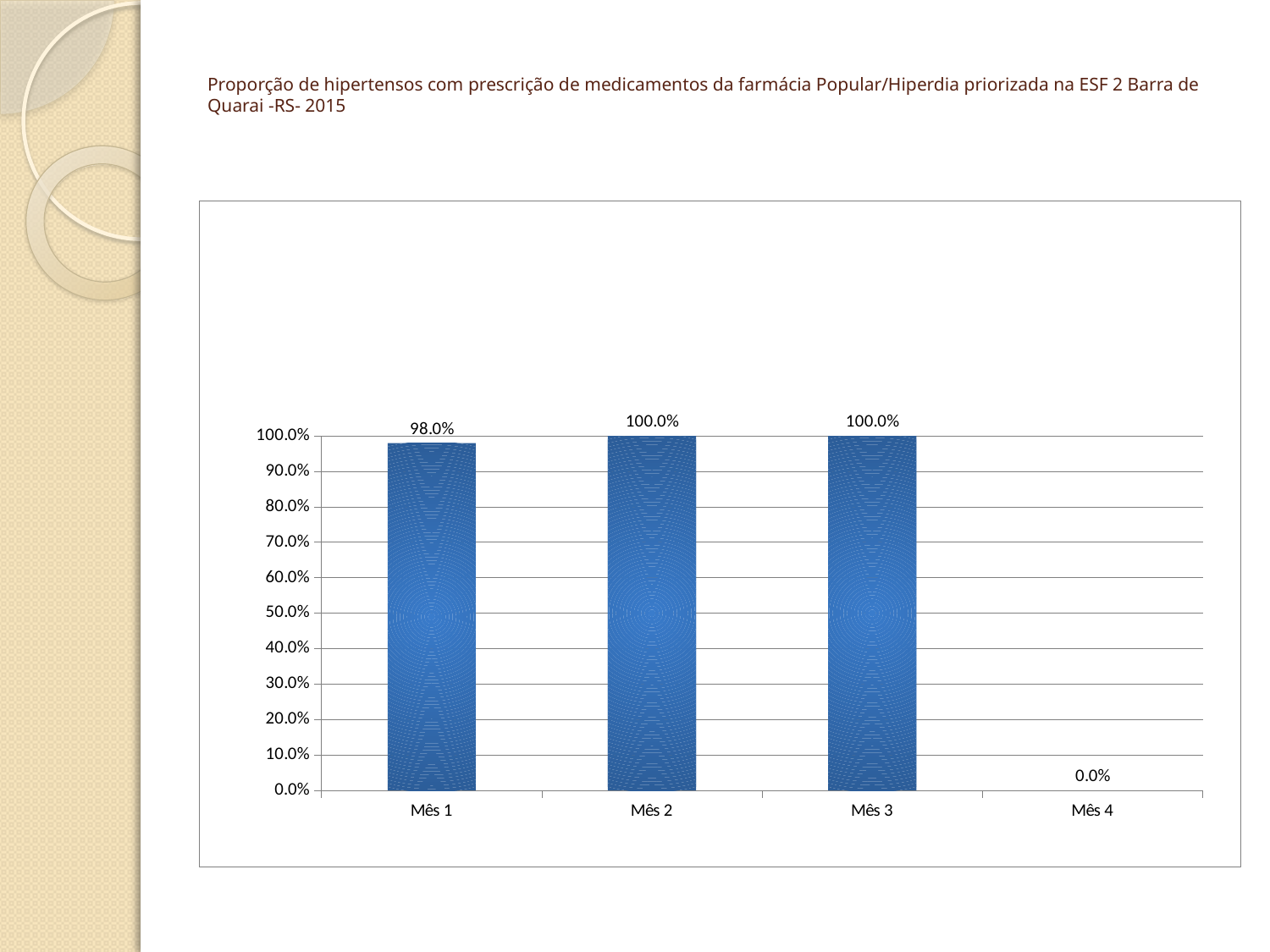
What is the value for Mês 2? 100.0% Which category has the lowest value? Mês 4 Is the value for Mês 1 greater or less than 90.0%? greater What kind of chart is shown on the slide? bar chart How many categories are shown on the x axis? 4 What is the difference between the values for Mês 3 and Mês 4? 100.0% What is the difference between the values for Mês 2 and Mês 1? 2.0% What colour are the bars in the chart? blue What is the value for Mês 1? 98.0% Do the values rise or fall from Mês 3 to Mês 4? fall Which is larger, the value for Mês 3 or the value for Mês 1? Mês 3 What is the value for Mês 4? 0.0%